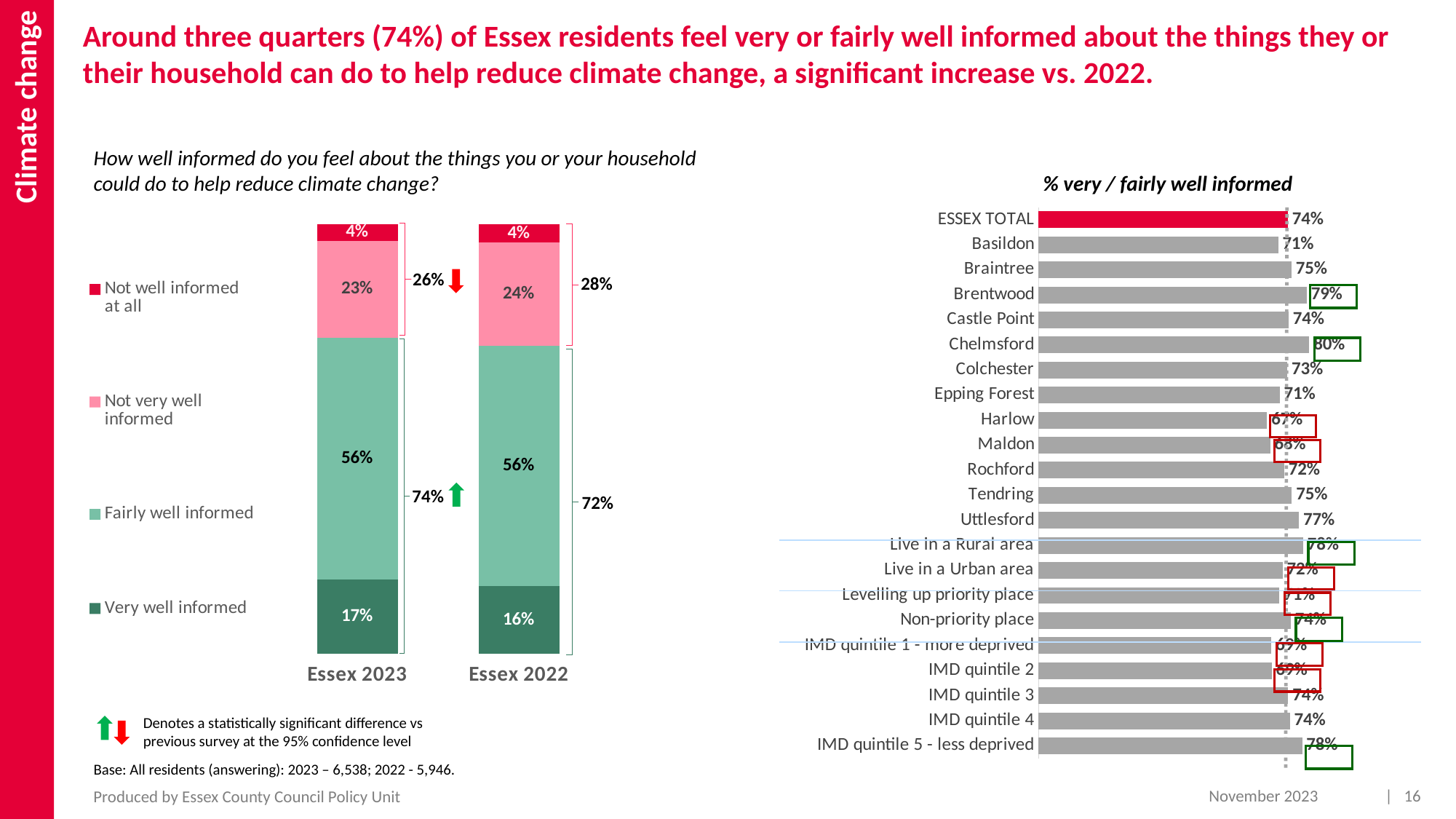
In the left stacked bar chart, what percentage of Essex 2023 respondents were 'Very well informed'? 17% What type of chart is the left chart comparing Essex 2023 and Essex 2022? Stacked bar chart In the left stacked bar chart, what is the difference between the 'Very well informed' share for Essex 2023 and Essex 2022? 1% In the '% very / fairly well informed' chart, which district has the highest value? Chelmsford In the left stacked bar chart, which segment is the largest for Essex 2023? Fairly well informed How many categories are plotted in the '% very / fairly well informed' chart? 22 In the left stacked bar chart, what percentage of Essex 2022 respondents were 'Not very well informed'? 24% How many series does the legend of the left stacked bar chart list? 4 In the '% very / fairly well informed' chart, what is the value for Uttlesford? 77% In the '% very / fairly well informed' chart, what is the value for Chelmsford? 80% In the '% very / fairly well informed' chart, which is larger, Brentwood or Basildon? Brentwood In the '% very / fairly well informed' chart, what is the difference between Chelmsford and ESSEX TOTAL? 6%